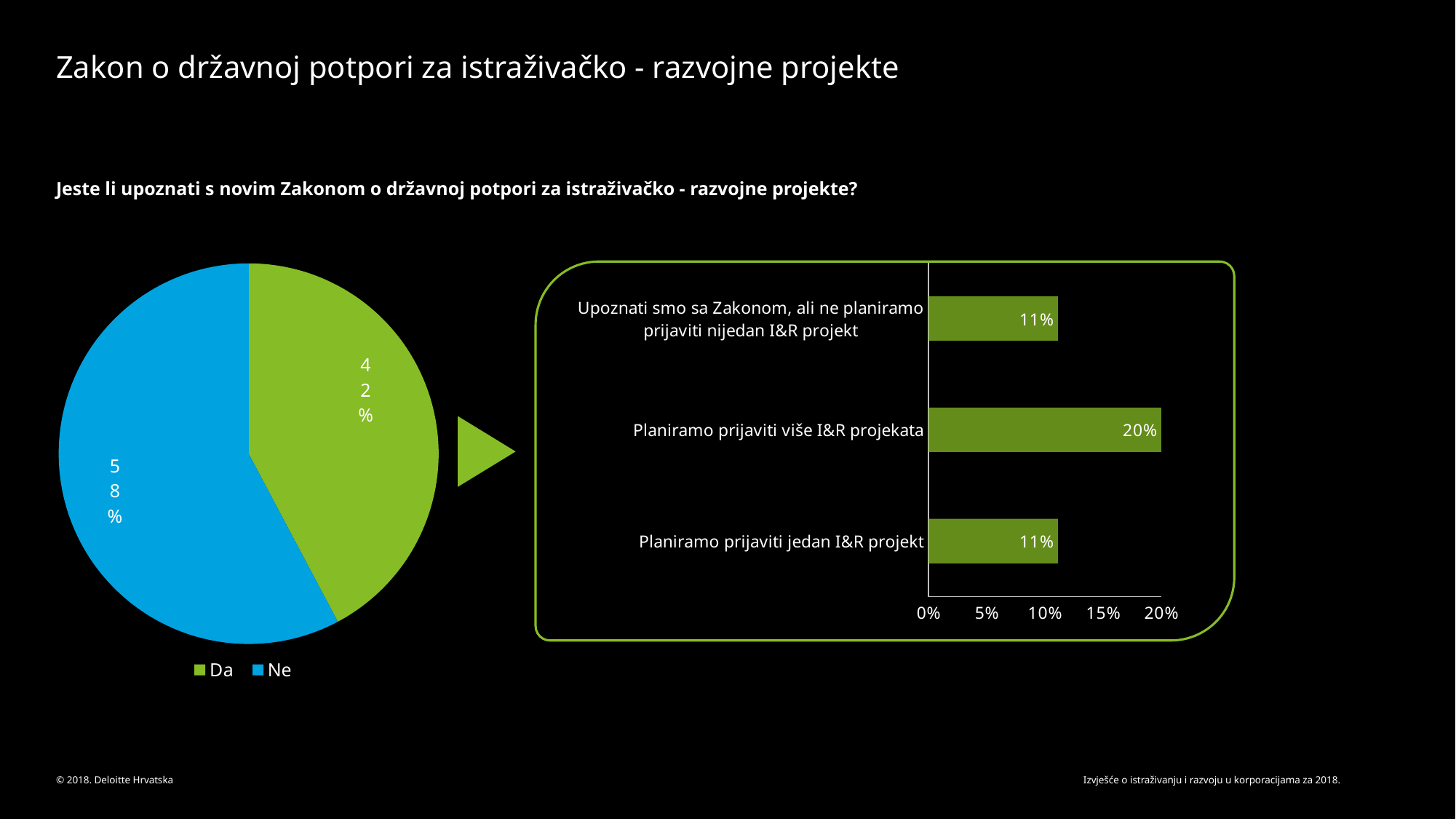
In the pie chart on the left, what share of respondents answered "Da"? 42% In the pie chart on the left, how many entries does the legend list? 2 What kind of chart is the chart on the left of the slide? Pie chart In the pie chart on the left, what share of respondents answered "Ne"? 58% In the bar chart on the right, what is the value for "Planiramo prijaviti jedan I&R projekt"? 11% In the bar chart on the right, what is the value for "Planiramo prijaviti više I&R projekata"? 20% In the pie chart on the left, which answer has the larger share, "Da" or "Ne"? Ne In the bar chart on the right, which category has the highest value? Planiramo prijaviti više I&R projekata What kind of chart is the chart on the right of the slide? Bar chart In the pie chart on the left, what is the difference between the "Ne" share and the "Da" share? 16% In the bar chart on the right, how many categories are shown? 3 In the bar chart on the right, what is the difference between "Planiramo prijaviti više I&R projekata" and "Upoznati smo sa Zakonom, ali ne planiramo prijaviti nijedan I&R projekt"? 9%